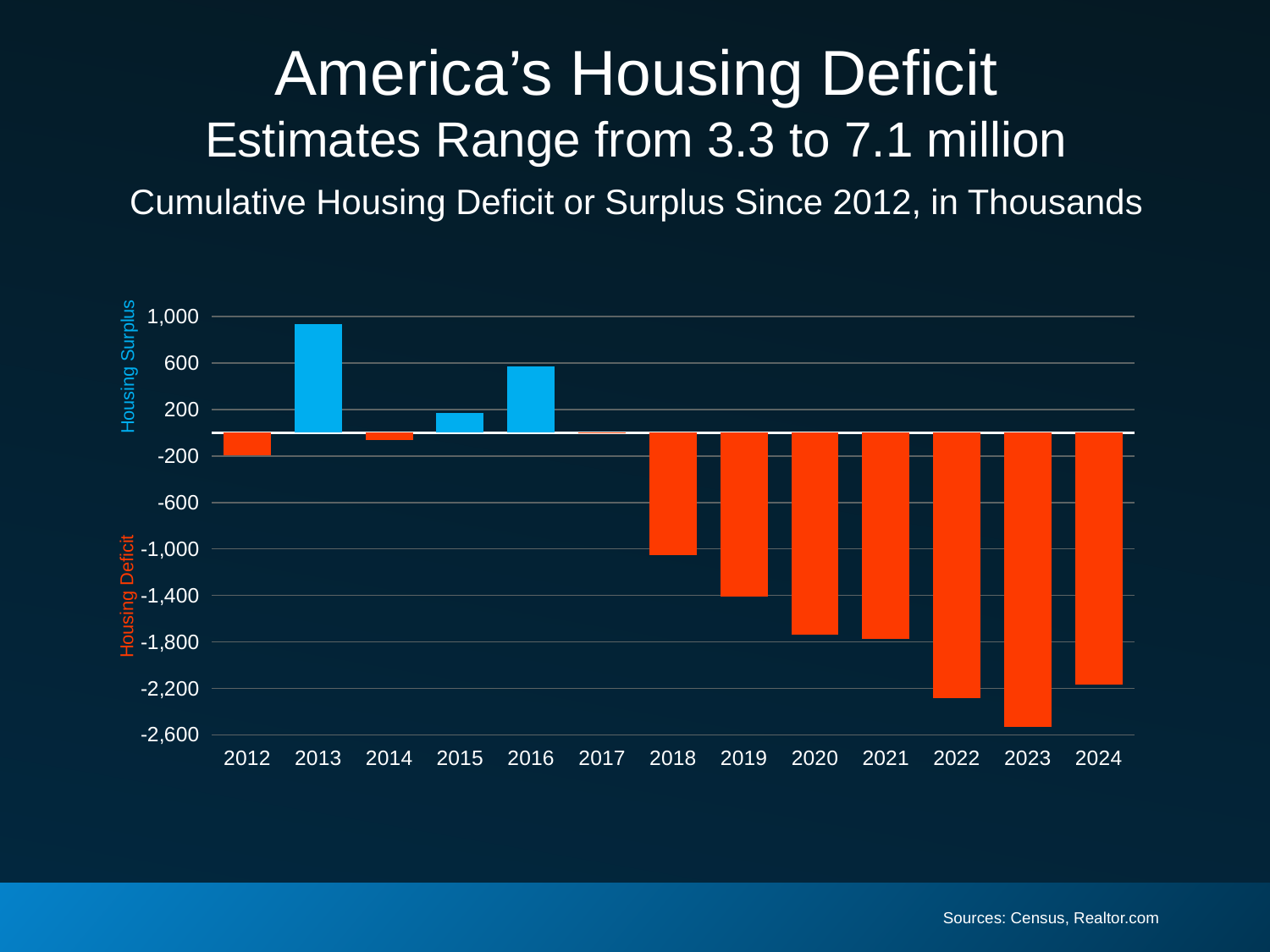
Is the value for 2018 greater or less than -600? less Which year has the lowest value in the chart? 2023 What kind of chart is shown on the slide? bar chart Which is larger, the value for 2022 or the value for 2024? 2024 Is the value for 2023 greater or less than -2,200? less Do the values rise or fall from 2018 to 2023? fall How many years are shown on the x axis of the chart? 13 Is the value for 2013 greater or less than 600? greater What colour are the bars representing a housing deficit? red Which is larger, the value for 2013 or the value for 2016? 2013 Which year has the highest value in the chart? 2013